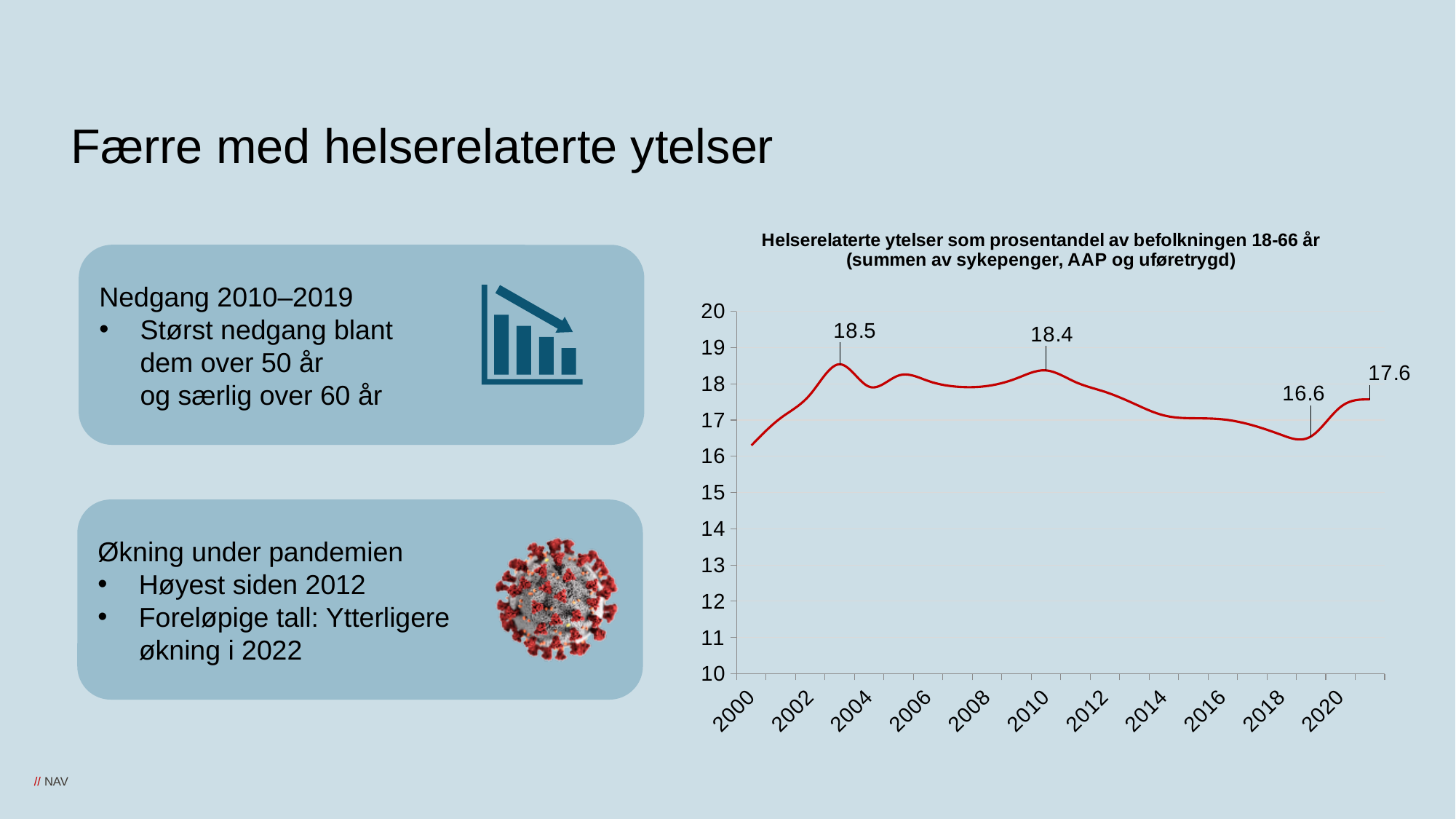
What is the difference between the labelled value at 2010 (18.4) and the labelled value at 2019 (16.6)? 1.8 What is the labelled peak value of the line around 2003? 18.5 What is the title of the chart? Helserelaterte ytelser som prosentandel av befolkningen 18-66 år (summen av sykepenger, AAP og uføretrygd) What is the labelled value of the line at 2019? 16.6 Does the line rise or fall between 2010 and 2019? fall Is the labelled value at 2003 or the labelled value at 2010 larger? 2003 (18.5) Which labelled value on the chart is the highest? 18.5 Is the value of the line at 2000 greater or less than 17? less What type of chart is shown on the slide? line chart What is the labelled value of the line at 2010? 18.4 Which labelled value on the chart is the lowest? 16.6 What is the labelled value at the end of the line (2021)? 17.6